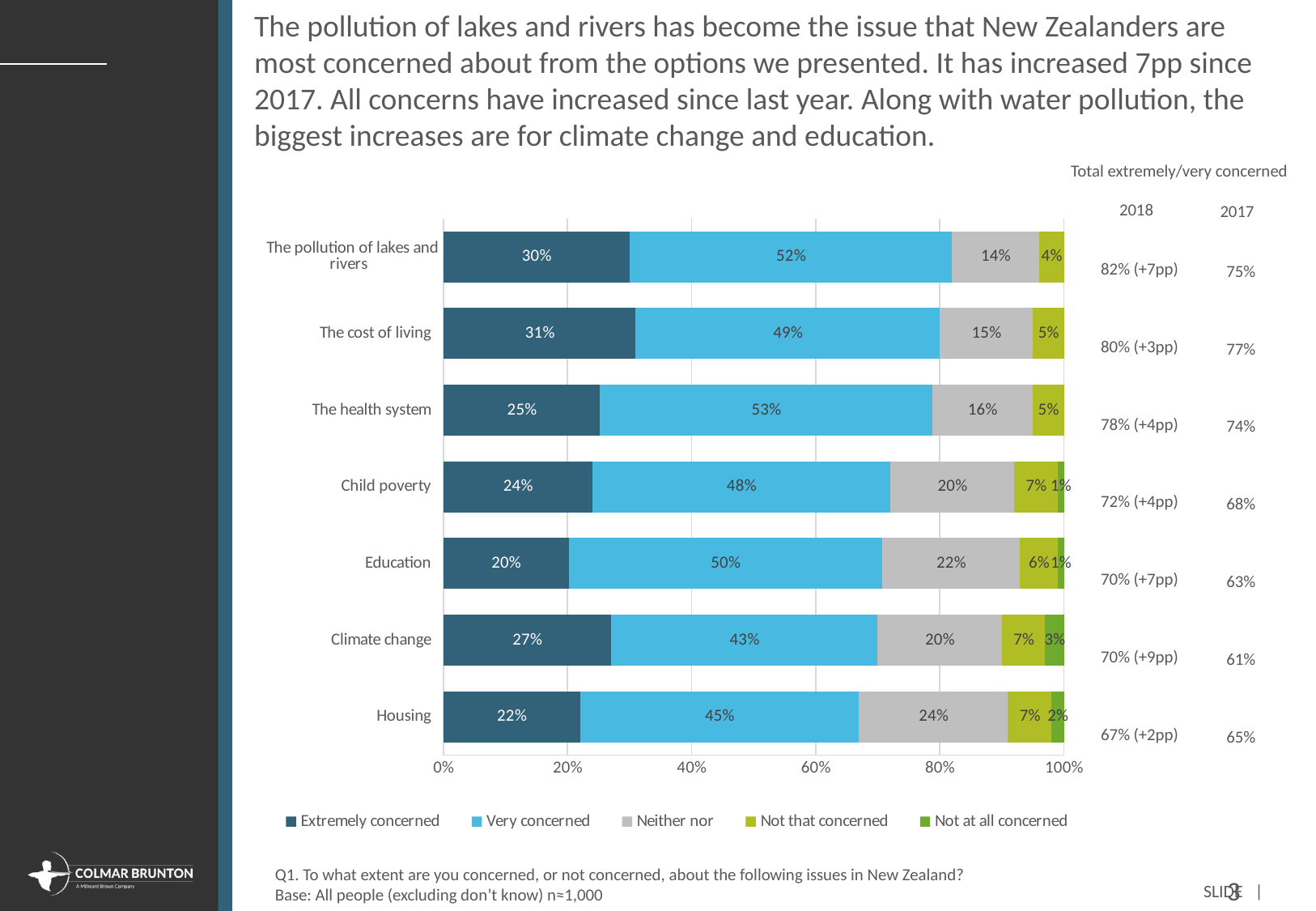
What is the combined 'Extremely concerned' and 'Very concerned' total for the pollution of lakes and rivers? 82% What is the 'Neither nor' value for Housing? 24% How many series does the legend list? 5 According to the table on the right, what was the total extremely/very concerned figure for Climate change in 2017? 61% What is the difference between the 'Very concerned' values for the pollution of lakes and rivers and for climate change? 9% What percentage of respondents are 'Extremely concerned' about the cost of living? 31% Which issue has the lowest 'Very concerned' percentage? Climate change What kind of chart is shown on the slide? Stacked bar chart What is the 'Very concerned' value for the health system? 53% Which has a larger 'Neither nor' value, Education or Child poverty? Education How many issues are shown on the chart? 7 Which issue has the highest 'Extremely concerned' percentage? The cost of living